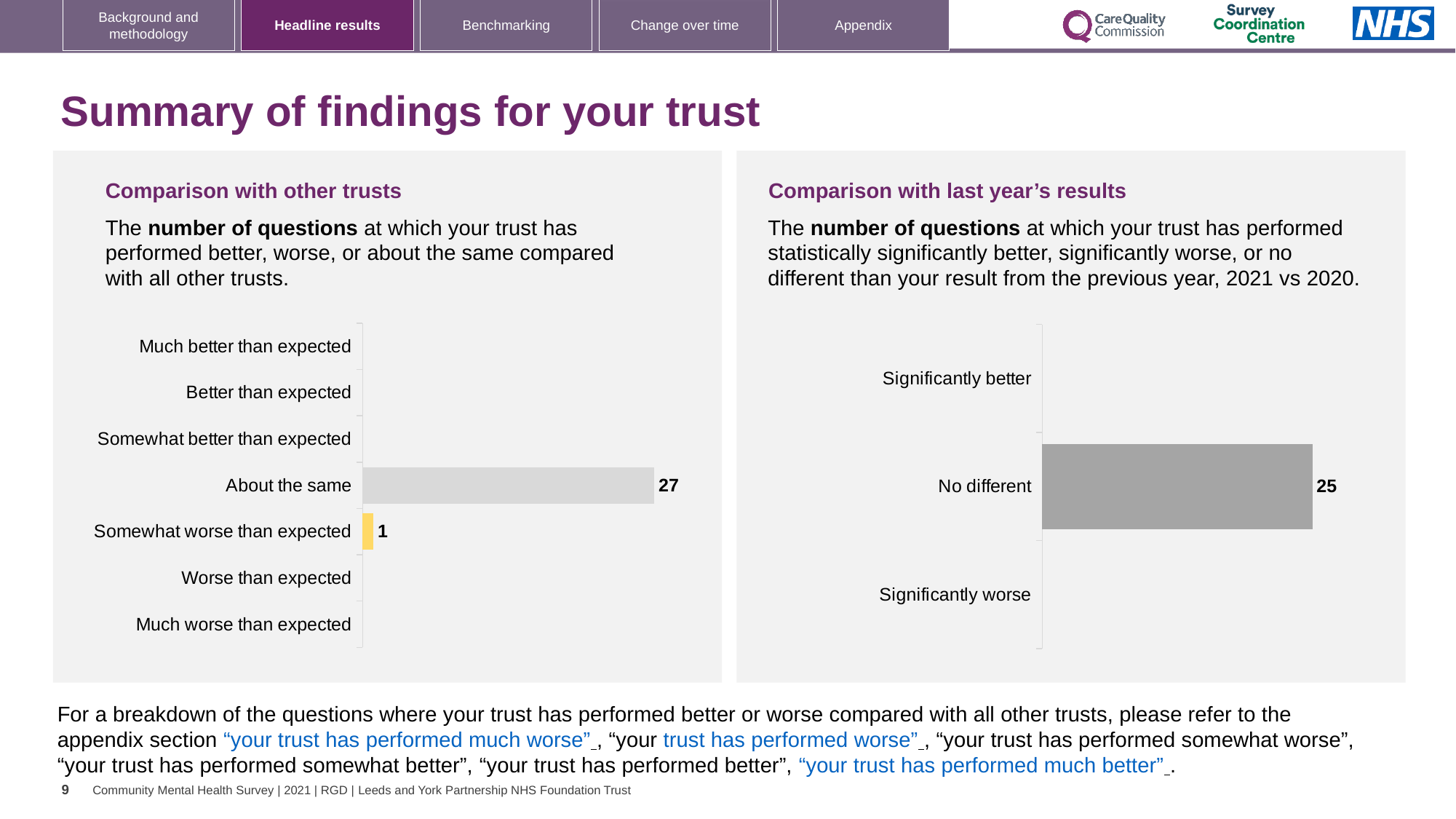
How many categories are listed on the 'Comparison with last year's results' chart? 3 How many categories are listed on the 'Comparison with other trusts' chart? 7 In the 'Comparison with other trusts' chart, which is larger: 'About the same' or 'Somewhat worse than expected'? About the same What type of chart is the 'Comparison with last year's results' chart? Bar chart In the 'Comparison with other trusts' chart, which category has the highest value? About the same In the 'Comparison with other trusts' chart, what is the value for 'Somewhat worse than expected'? 1 In the 'Comparison with last year's results' chart, what is the value for 'No different'? 25 In the 'Comparison with other trusts' chart, what is the difference between the values for 'About the same' and 'Somewhat worse than expected'? 26 Is the value for 'About the same' in the left chart larger than the value for 'No different' in the right chart? Yes In the 'Comparison with other trusts' chart, how many questions are 'About the same'? 27 What is the title of the chart on the right side of the slide? Comparison with last year's results In the 'Comparison with last year's results' chart, which category has the highest value? No different